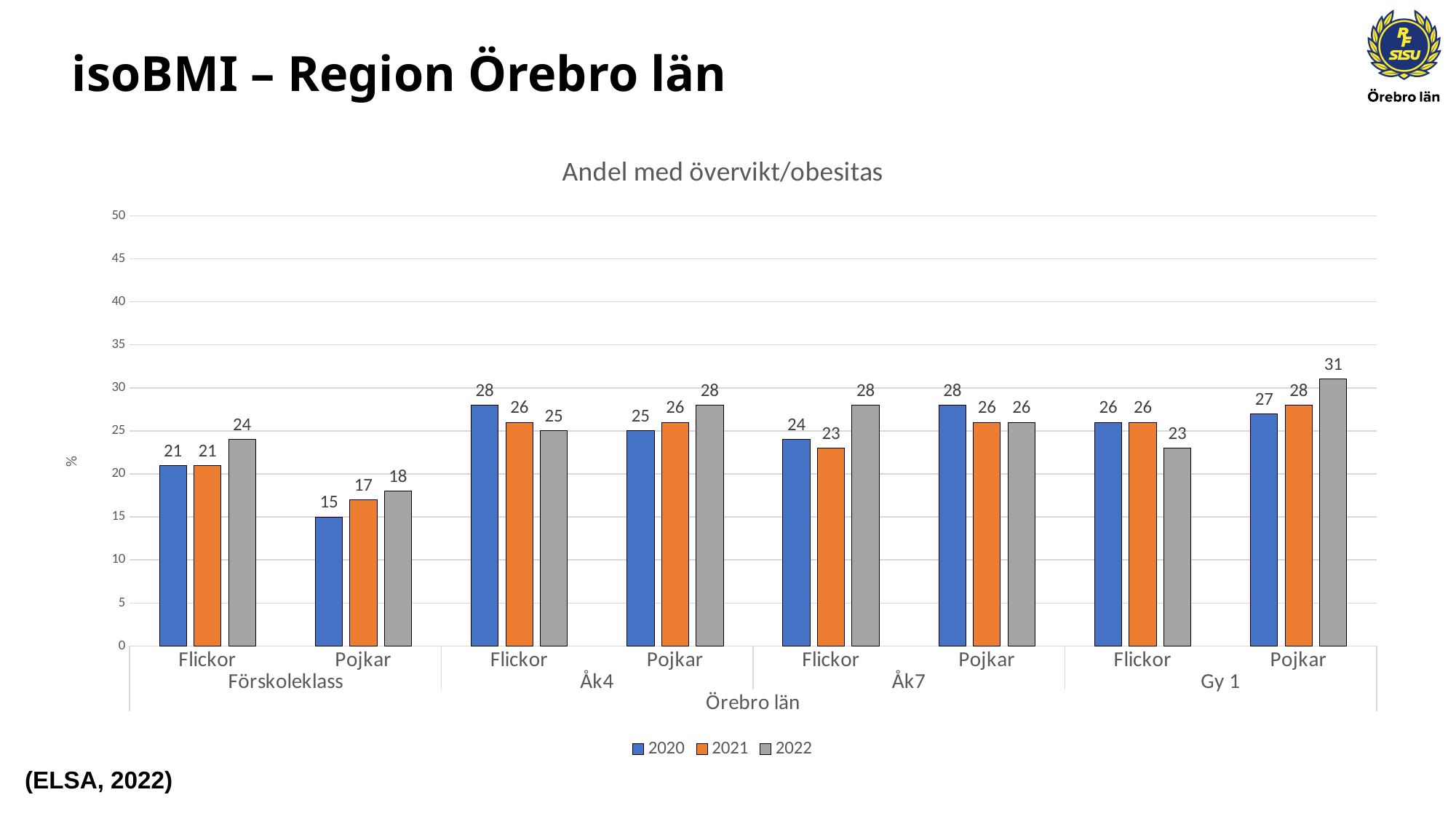
What kind of chart is shown on the slide? Bar chart What is the difference between the 2022 and 2020 values for Pojkar in Förskoleklass? 3 Which group and year has the lowest value in the chart? Pojkar, Förskoleklass, 2020 Is the 2022 value for Pojkar in Gy 1 greater or less than 30? greater What is the title of the chart? Andel med övervikt/obesitas Which group and year has the highest value in the chart? Pojkar, Gy 1, 2022 How many series does the legend list? 3 What is the value for Pojkar in Förskoleklass for 2020? 15 What is the value for Flickor in Åk7 for 2022? 28 What is the value for Pojkar in Gy 1 for 2022? 31 Which is larger for Flickor in Gy 1: the 2020 value or the 2022 value? 2020 Do the values for Pojkar in Förskoleklass rise or fall from 2020 to 2022? Rise